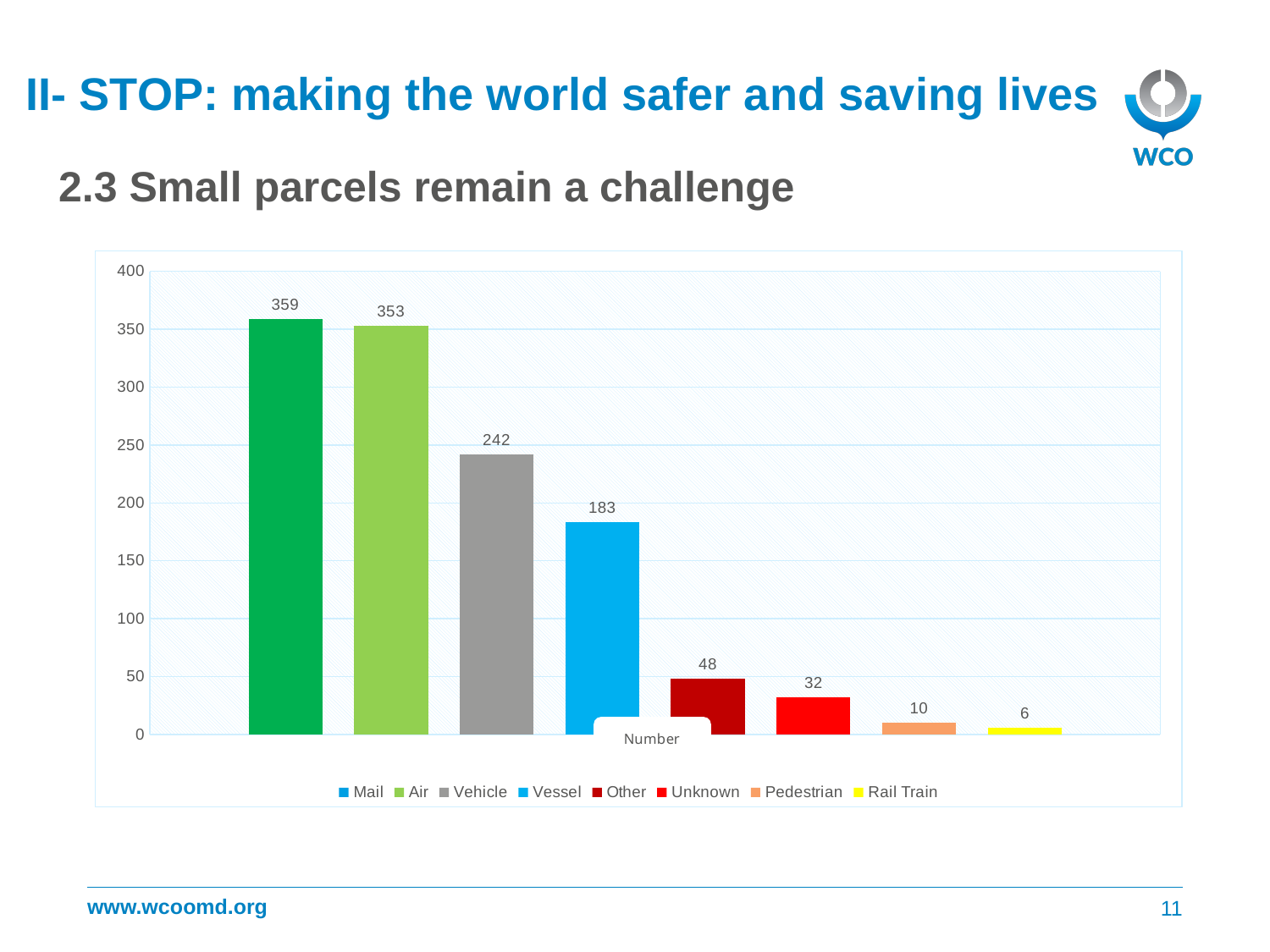
What is the label shown on the x axis of the chart? Number What is the difference between the values for Other and Unknown? 16 What is the value for Mail? 359 How many series does the legend list? 8 Which series has the highest value? Mail Which is larger, the value for Air or the value for Vessel? Air What is the difference between the values for Vehicle and Vessel? 59 What kind of chart is shown on the slide? bar chart Which series has the lowest value? Rail Train What is the value for Vehicle? 242 Is the value for Vessel greater or less than 200? less What is the value for Pedestrian? 10